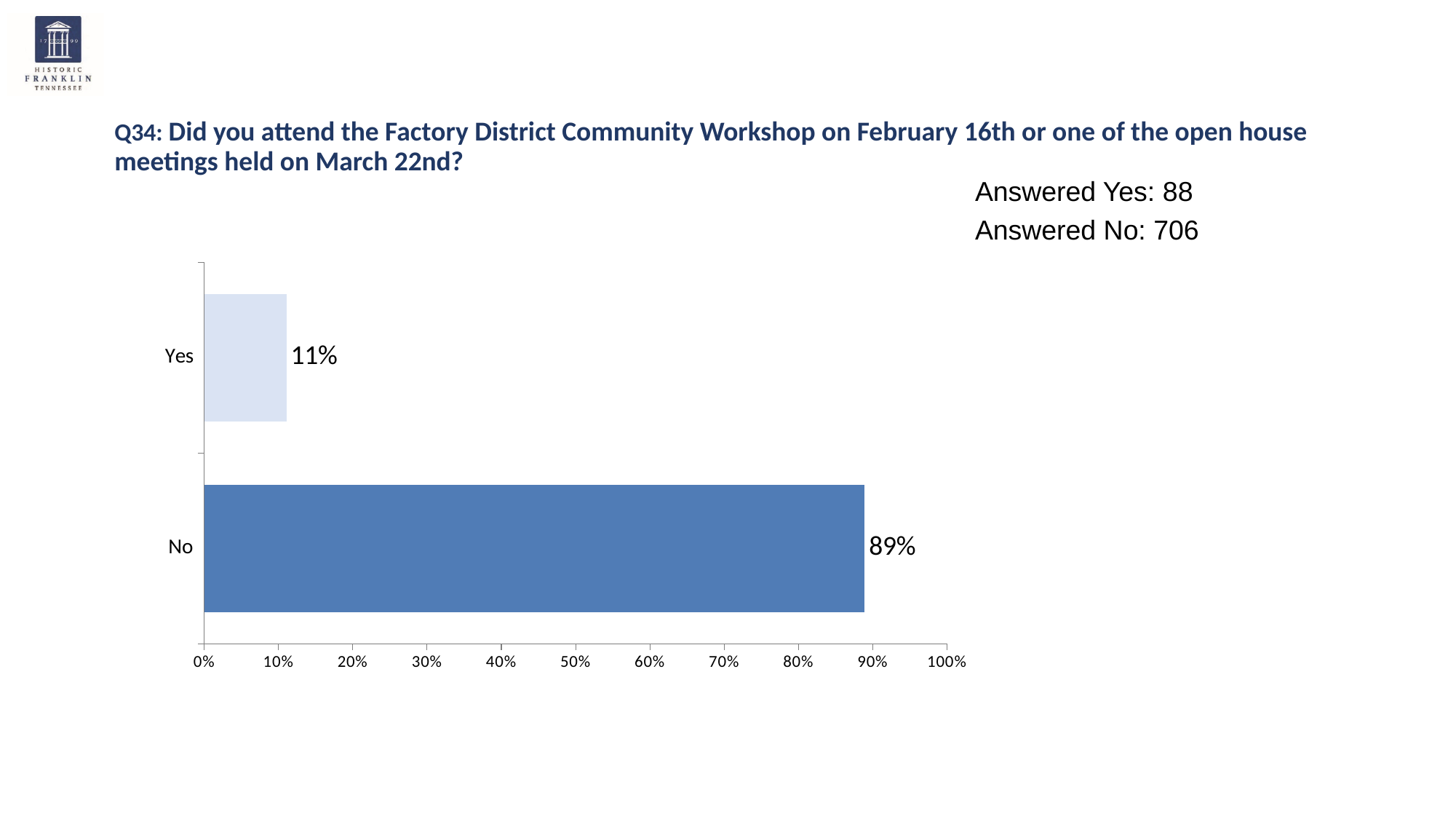
Is the value for Yes greater or less than 20%? less How many respondents answered Yes according to the text on the slide? 88 What percentage of respondents answered No? 89% Which category has the lowest value? Yes What percentage of respondents answered Yes? 11% Which category has the highest value? No What kind of chart is shown on the slide? bar chart What is the highest value shown on the x axis? 100% How many categories are shown on the chart? 2 Is the value for No greater or less than 80%? greater What is the difference in percentage points between the No and Yes bars? 78 Which is larger, the value for Yes or the value for No? No